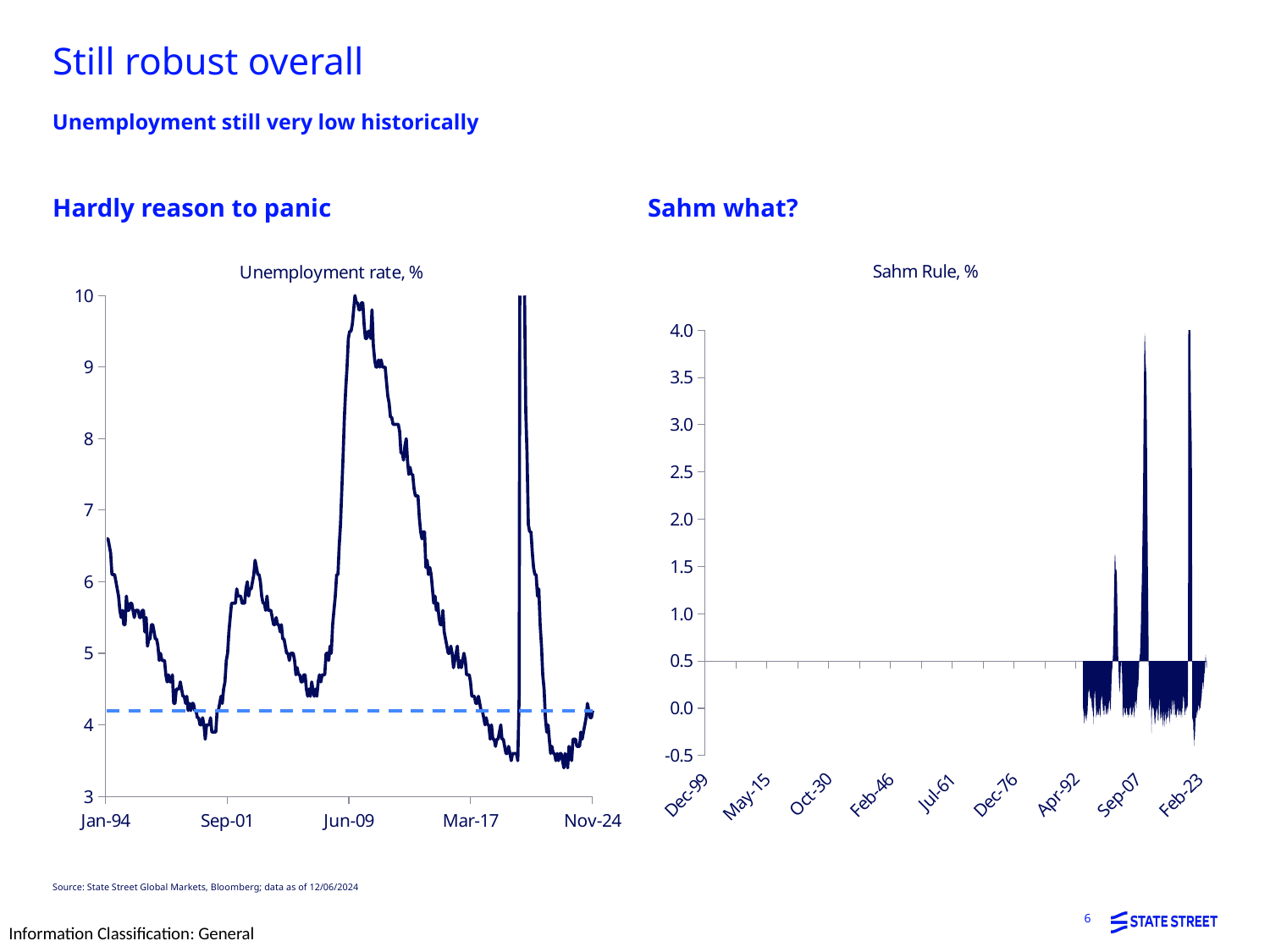
On the 'Unemployment rate, %' chart, does the unemployment rate rise or fall between Jan-94 and Sep-01? fall What is the first x-axis label on the 'Sahm Rule, %' chart? Dec-99 On the 'Unemployment rate, %' chart, does the unemployment rate rise or fall between Jun-09 and Mar-17? fall On the 'Unemployment rate, %' chart, is the value at Mar-17 greater or less than 5? less On the 'Unemployment rate, %' chart, is the value at Jun-09 greater or less than 9? greater On the 'Unemployment rate, %' chart, is the value at Nov-24 greater or less than 5? less What is the title of the chart on the left of the slide? Unemployment rate, % What kind of chart is the 'Unemployment rate, %' chart on the left? line chart